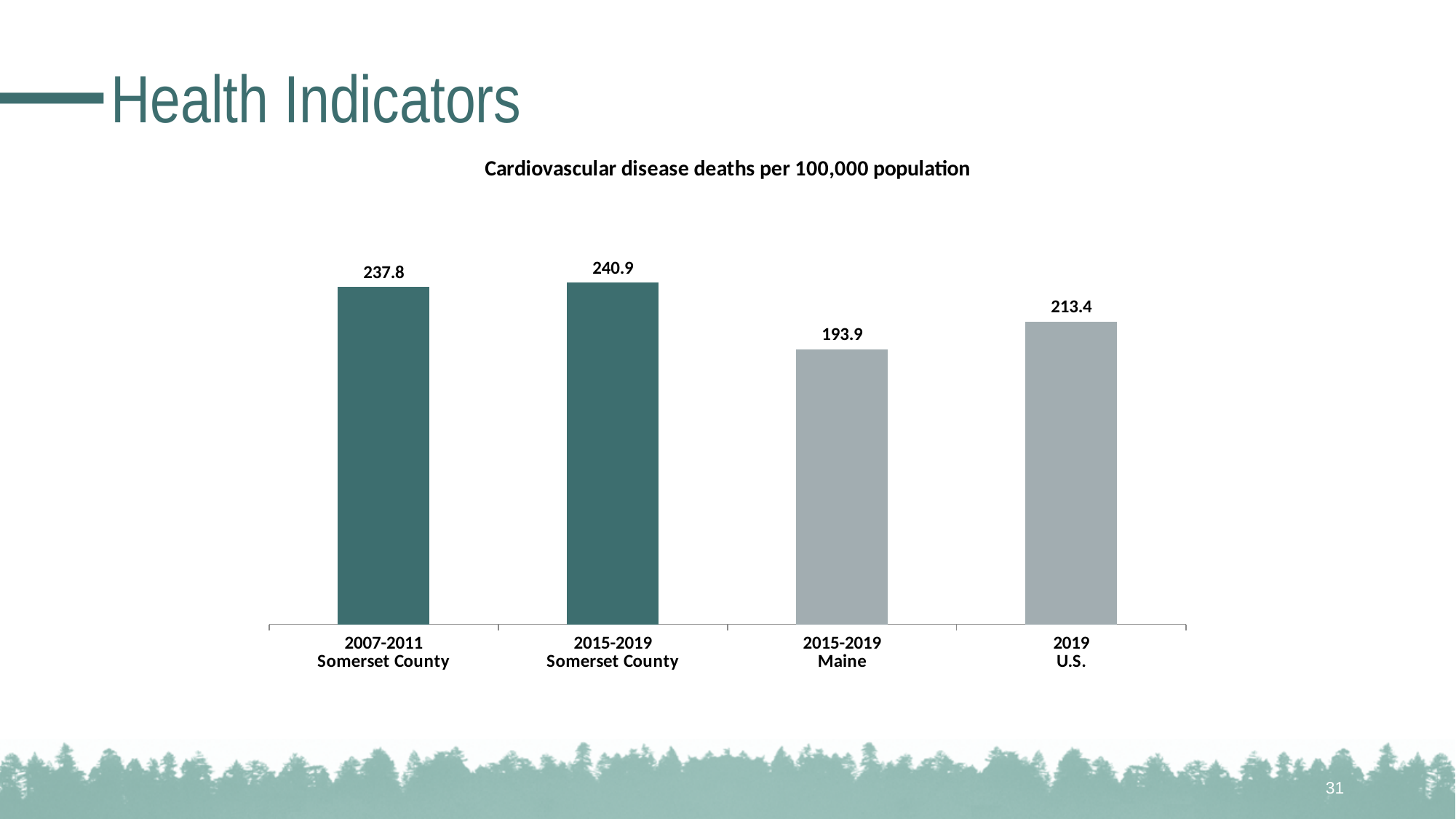
What is the difference between the values for 2019 U.S. and 2015-2019 Maine? 19.5 What is the value for 2015-2019 Maine? 193.9 Which category has the lowest value? 2015-2019 Maine What is the value for 2019 U.S.? 213.4 What is the difference between the values for 2015-2019 Somerset County and 2015-2019 Maine? 47.0 What is the value for 2015-2019 Somerset County? 240.9 How many bars are shown in the chart? 4 Which is larger, the value for 2007-2011 Somerset County or the value for 2019 U.S.? 2007-2011 Somerset County Which category has the highest value? 2015-2019 Somerset County What is the title of the chart? Cardiovascular disease deaths per 100,000 population What kind of chart is shown on the slide? Bar chart What is the value for 2007-2011 Somerset County? 237.8